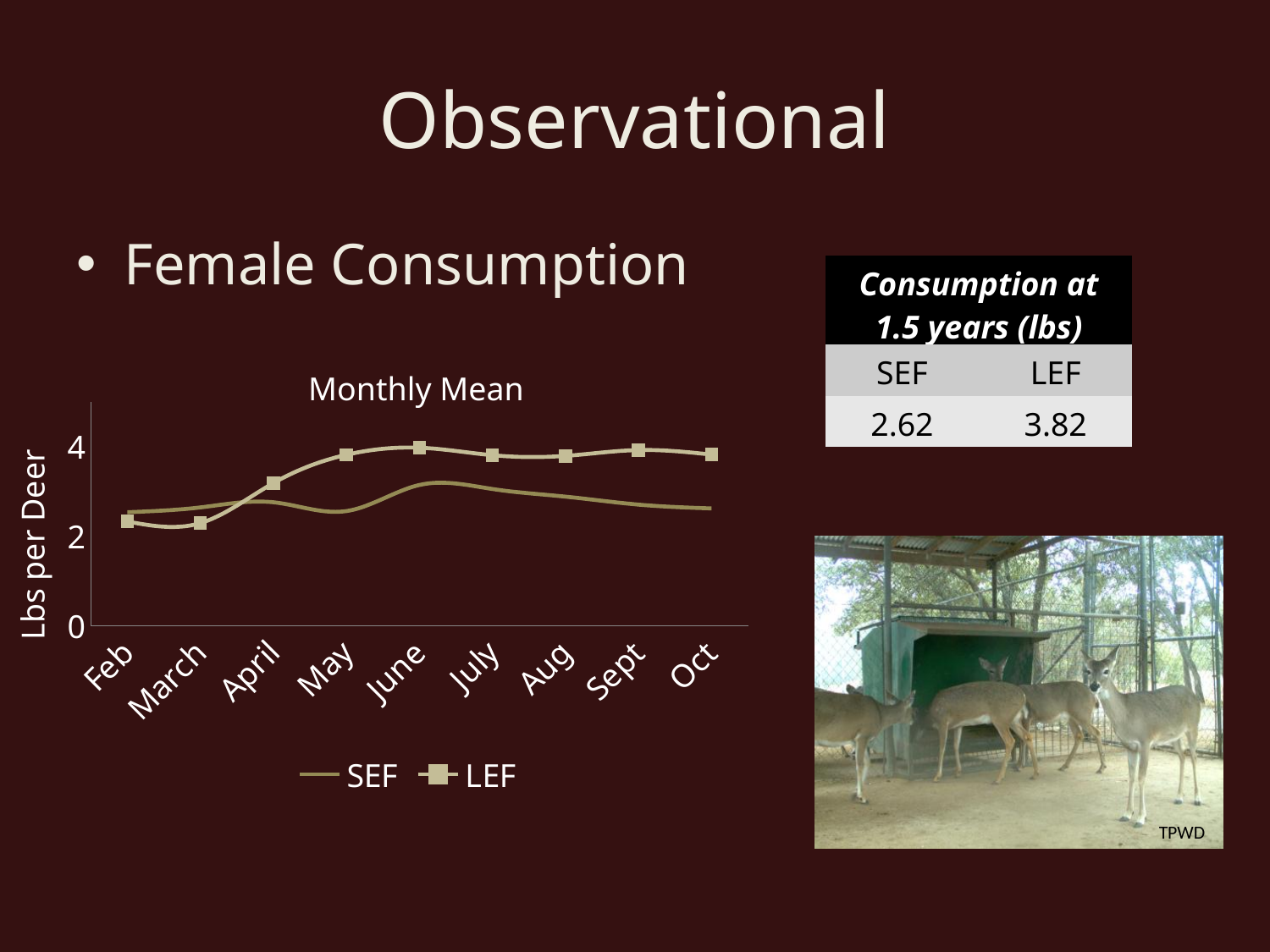
What type of chart is shown on the slide? line chart In Oct, which series has the higher value, SEF or LEF? LEF How many months are plotted along the x axis of the chart? 9 What is the label on the chart's vertical axis? Lbs per Deer Is the value for LEF in Feb greater or less than 2? greater Is the value for SEF in Oct greater or less than 2? greater What is the title of the chart? Monthly Mean In June, which series has the higher value, SEF or LEF? LEF Is the value for SEF in June greater or less than 4? less Does the LEF series rise or fall from Feb to June? rise How many series does the chart's legend list? 2